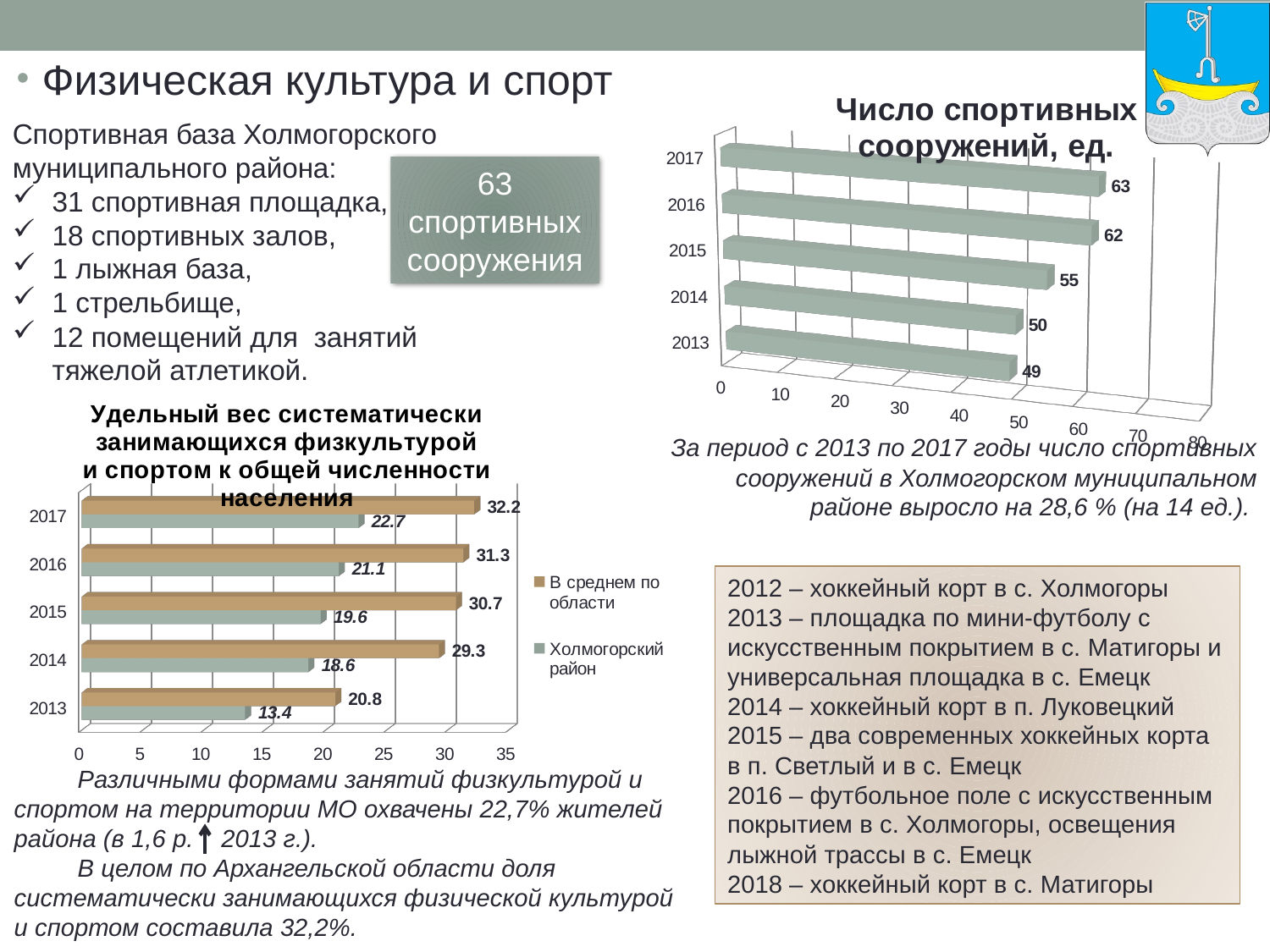
In the chart 'Число спортивных сооружений, ед.', what is the value for 2017? 63 In the chart 'Число спортивных сооружений, ед.', what is the value for 2013? 49 In the chart 'Число спортивных сооружений, ед.', which year has the lowest value? 2013 In the chart 'Удельный вес систематически занимающихся физкультурой и спортом к общей численности населения', what is the value for Холмогорский район in 2017? 22.7 What kind of chart is 'Удельный вес систематически занимающихся физкультурой и спортом к общей численности населения'? bar chart In the chart 'Число спортивных сооружений, ед.', do the values rise or fall from 2013 to 2017? rise In the chart 'Число спортивных сооружений, ед.', what is the difference between the values for 2017 and 2013? 14 In the chart 'Число спортивных сооружений, ед.', how many years are shown? 5 In the chart 'Удельный вес систематически занимающихся физкультурой и спортом к общей численности населения', what is the difference between В среднем по области and Холмогорский район in 2015? 11.1 In the chart 'Удельный вес систематически занимающихся физкультурой и спортом к общей численности населения', how many series does the legend list? 2 In the chart 'Удельный вес систематически занимающихся физкультурой и спортом к общей численности населения', which is larger in 2014: В среднем по области or Холмогорский район? В среднем по области In the chart 'Удельный вес систематически занимающихся физкультурой и спортом к общей численности населения', what is the value for В среднем по области in 2013? 20.8